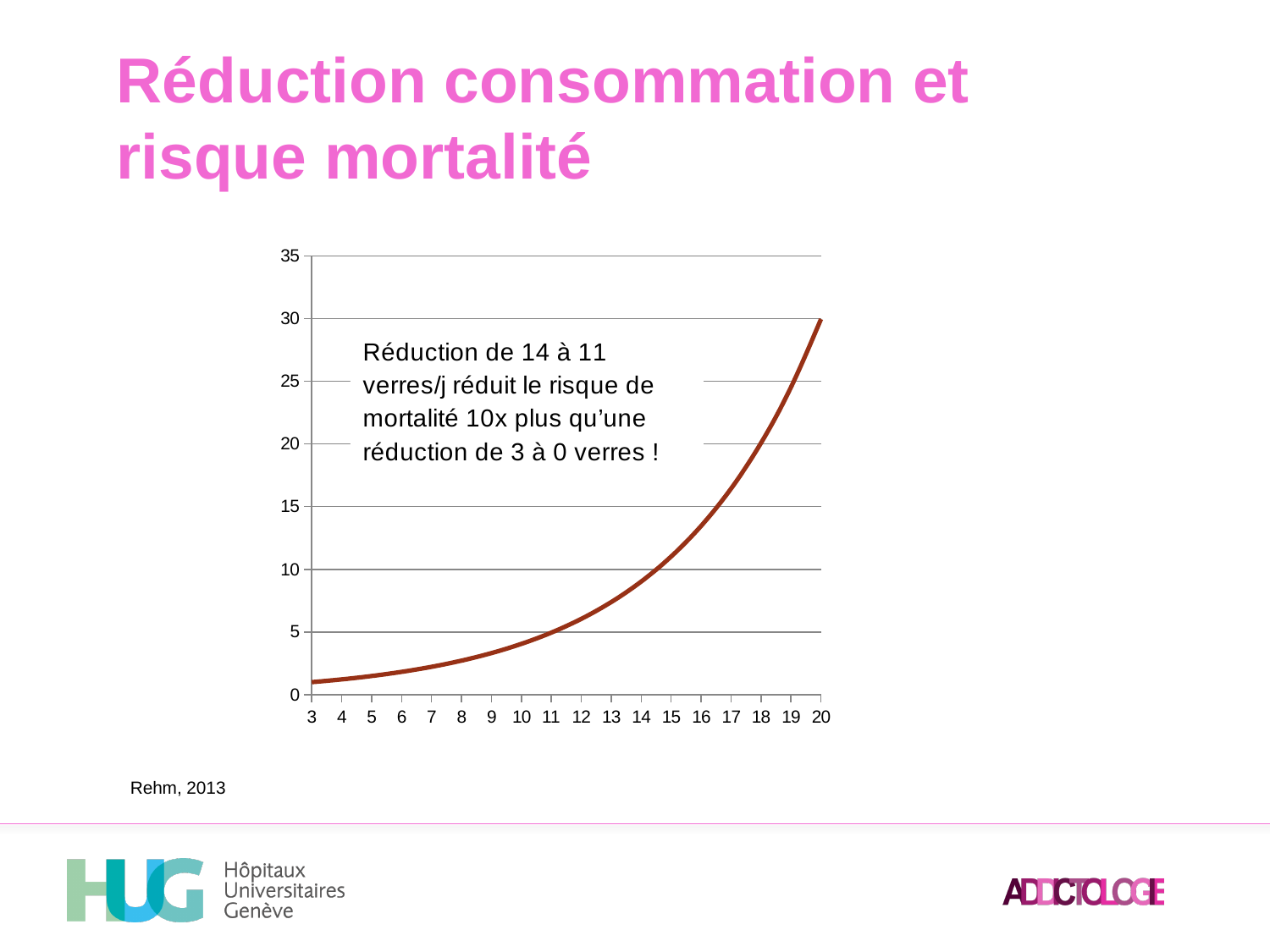
Is the value at x = 10 greater or less than 5? less What source is cited below the chart? Rehm, 2013 How many points are labelled on the x axis of the chart? 18 Is the value at x = 17 greater or less than 15? greater Which has the larger value, x = 20 or x = 3? x = 20 Do the values rise or fall as the x axis goes from 3 to 20? rise Is the value at x = 19 greater or less than 20? greater At which x value is the curve highest? 20 What is the title of the slide containing the chart? Réduction consommation et risque mortalité What kind of chart is shown on the slide? line chart